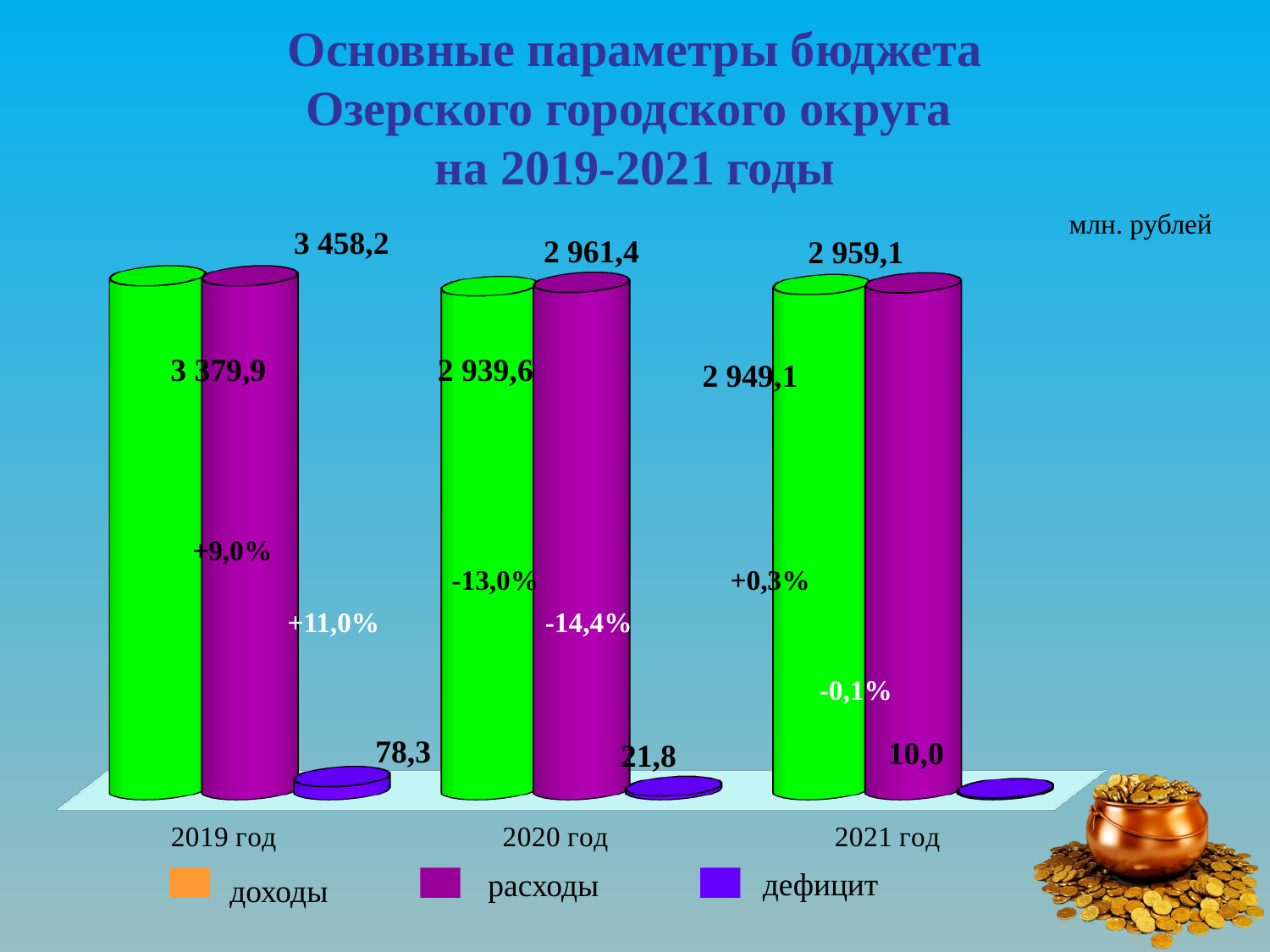
Does the дефицит rise or fall from 2019 год to 2021 год? fall What is the value of доходы for 2020 год? 2 939,6 How many years are shown on the x axis? 3 What is the value of расходы for 2019 год? 3 458,2 What is the value of дефицит for 2021 год? 10,0 Which is larger in 2021 год, доходы or расходы? расходы What unit is indicated for the values on the chart? млн. рублей What is the difference between расходы and доходы in 2019 год? 78,3 What kind of chart is shown on the slide? bar chart In which year is the дефицит the highest? 2019 год How many series does the legend list? 3 In which year is the value of доходы the lowest? 2020 год